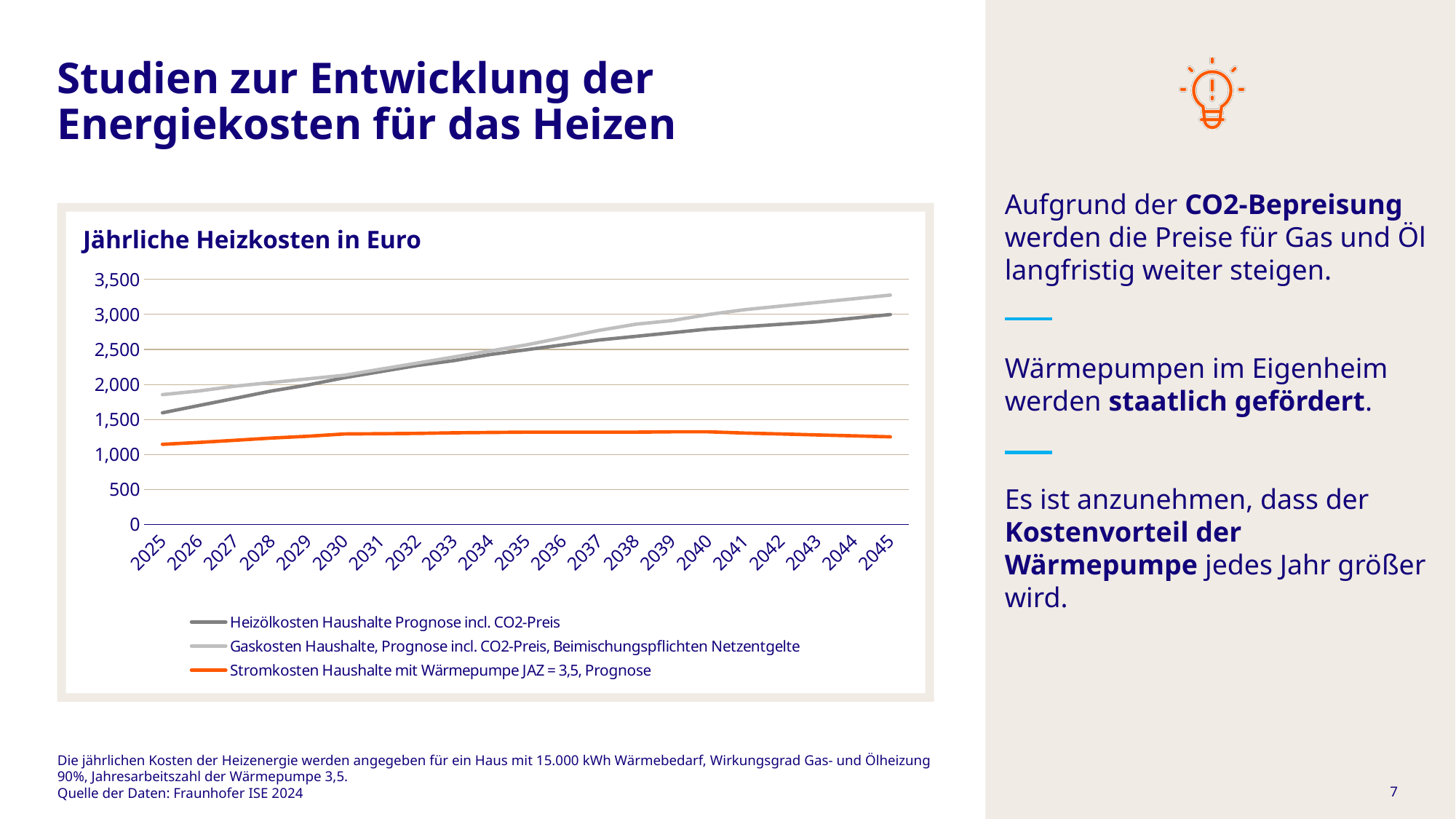
What is the title of the chart? Jährliche Heizkosten in Euro In 2025, which is larger: Gaskosten Haushalte or Heizölkosten Haushalte? Gaskosten Haushalte Is the value for Stromkosten Haushalte mit Wärmepumpe in 2040 greater or less than 1,500? less How many years are plotted along the x axis of the chart? 21 Do the Heizölkosten Haushalte values rise or fall from 2025 to 2045? rise What kind of chart is shown on the slide? line chart Which series has the lowest value in 2045? Stromkosten Haushalte mit Wärmepumpe JAZ = 3,5, Prognose Is the value for Heizölkosten Haushalte in 2025 greater or less than 1,500? greater Which series has the highest value in 2045? Gaskosten Haushalte, Prognose incl. CO2-Preis, Beimischungspflichten Netzentgelte Is the value for Gaskosten Haushalte in 2045 greater or less than 3,000? greater How many series does the legend of the chart list? 3 Which series is drawn in orange in the chart? Stromkosten Haushalte mit Wärmepumpe JAZ = 3,5, Prognose